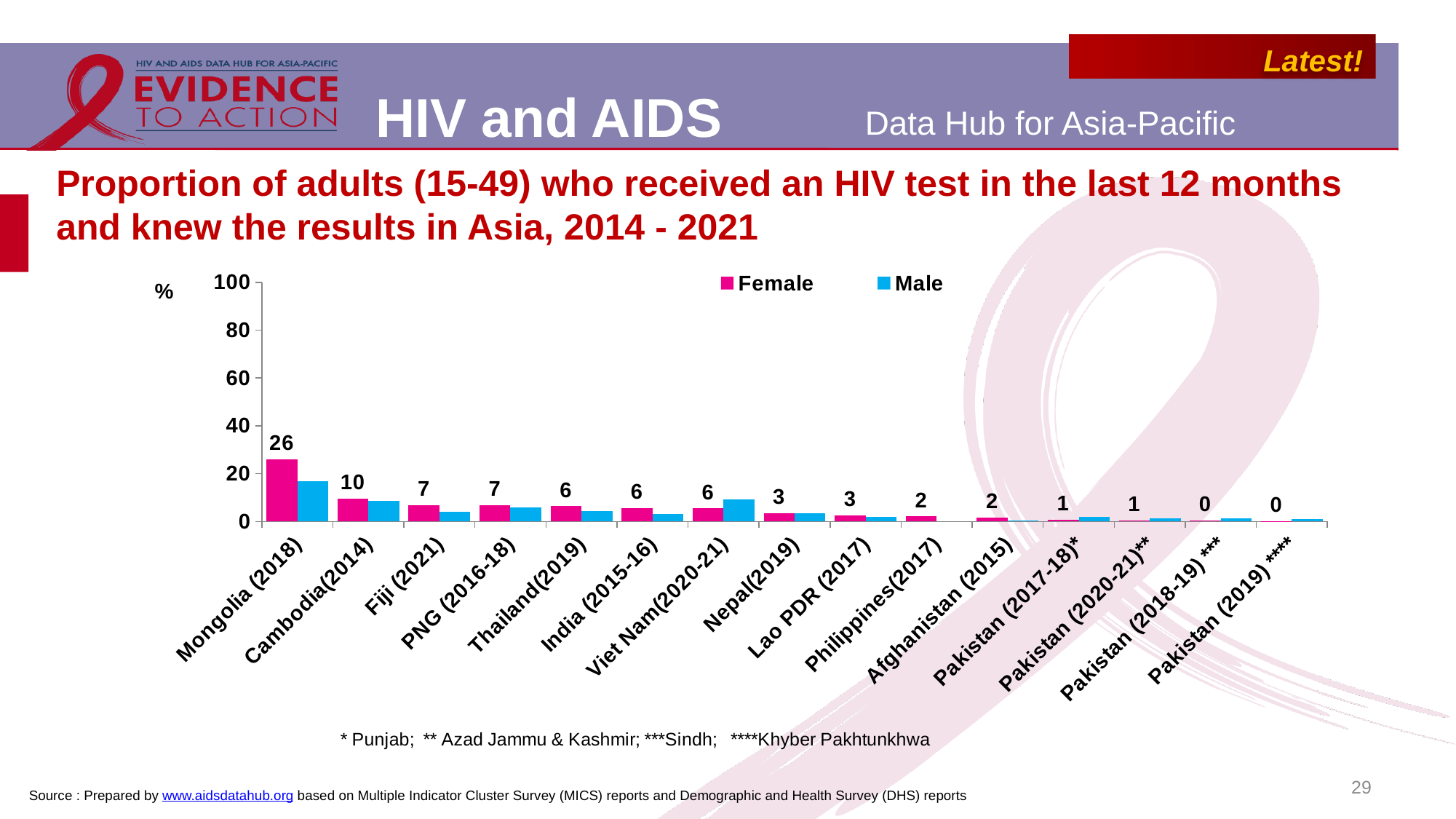
Which is larger, the Female value for Fiji (2021) or the Female value for Lao PDR (2017)? Fiji (2021) What is the Female value for Nepal(2019)? 3 How many series does the legend list? 2 What is the Female value for Afghanistan (2015)? 2 What is the Female value for Cambodia(2014)? 10 What is the Female value for Mongolia (2018)? 26 Which country has the highest Female value? Mongolia (2018) How many countries/categories are shown on the x axis? 15 Is the Female value for Mongolia (2018) greater or less than 20? greater What is the difference between the Female values for Mongolia (2018) and Cambodia(2014)? 16 What kind of chart is shown on the slide? Bar chart Is the Male value for Mongolia (2018) greater or less than 20? less